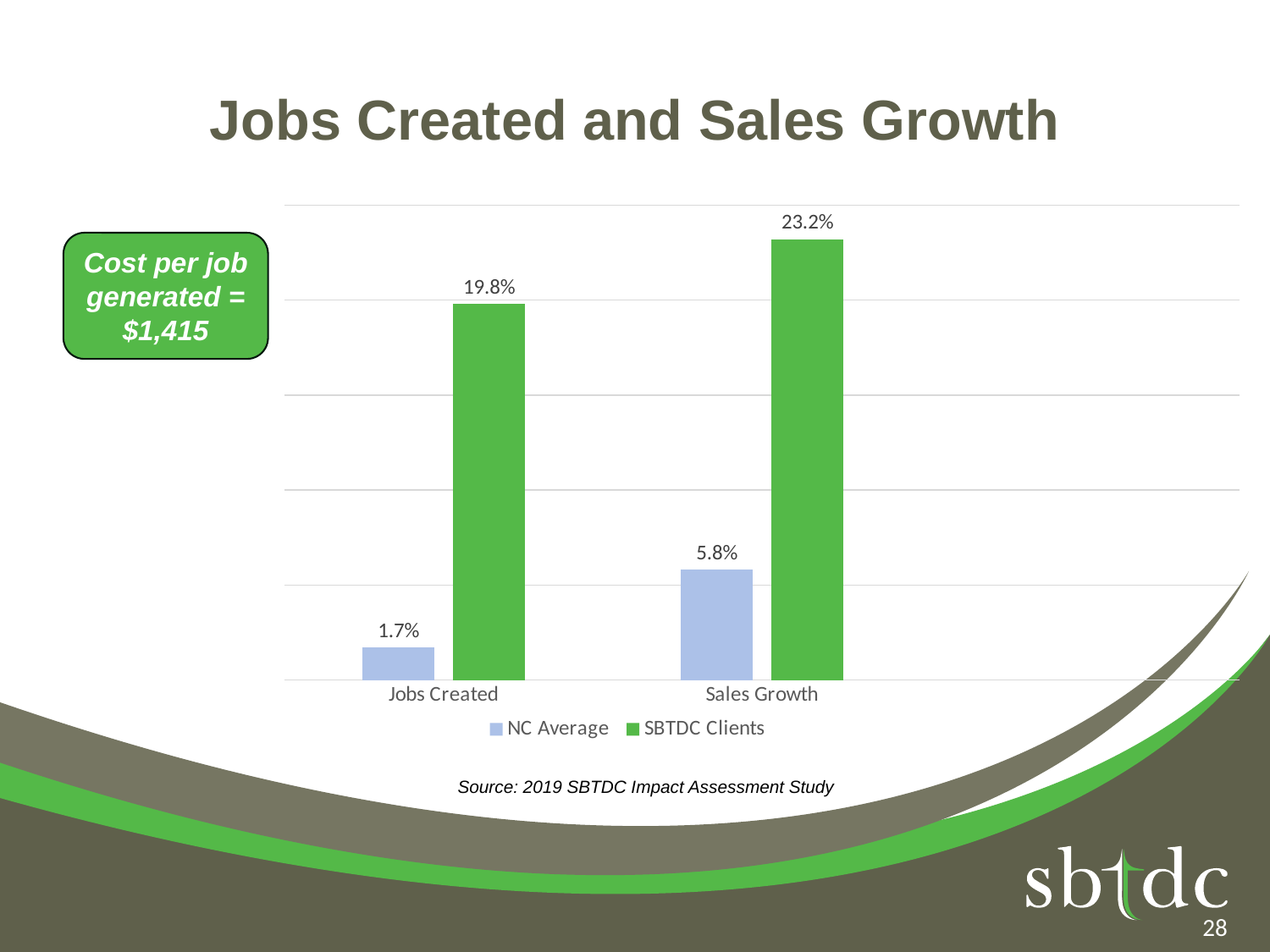
Which category has the highest SBTDC Clients value? Sales Growth Which category has the lowest NC Average value? Jobs Created How many series does the legend list? 2 What is the SBTDC Clients value for Jobs Created? 19.8% What is the NC Average value for Jobs Created? 1.7% What kind of chart is shown on the slide? Bar chart What is the NC Average value for Sales Growth? 5.8% Which is larger for Sales Growth: the NC Average value or the SBTDC Clients value? SBTDC Clients What is the difference between the SBTDC Clients and NC Average values for Sales Growth? 17.4% What is the SBTDC Clients value for Sales Growth? 23.2% How many categories are shown on the x axis? 2 What is the difference between the SBTDC Clients and NC Average values for Jobs Created? 18.1%